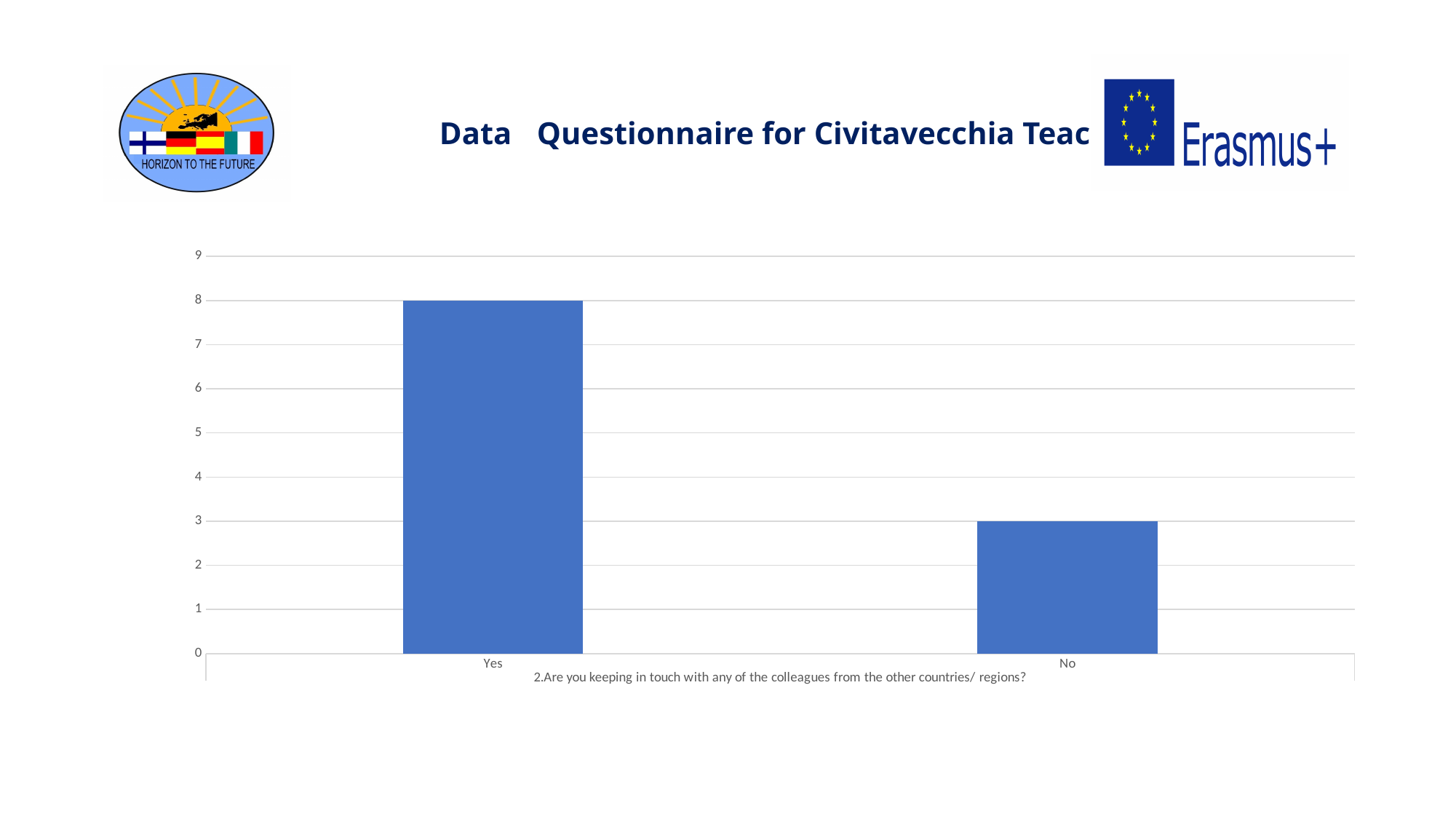
Is the value for No greater or less than 5? less How many categories are shown on the x axis? 2 What is the value for No? 3 What kind of chart is shown on the slide? bar chart What is the highest value shown on the vertical axis? 9 Which category has the highest value? Yes What is the difference between the values for Yes and No? 5 Which category has the lowest value? No Is the value for Yes greater or less than 5? greater Which is larger, the value for Yes or the value for No? Yes What question is written below the x axis of the chart? 2.Are you keeping in touch with any of the colleagues from the other countries/ regions? What is the value for Yes? 8